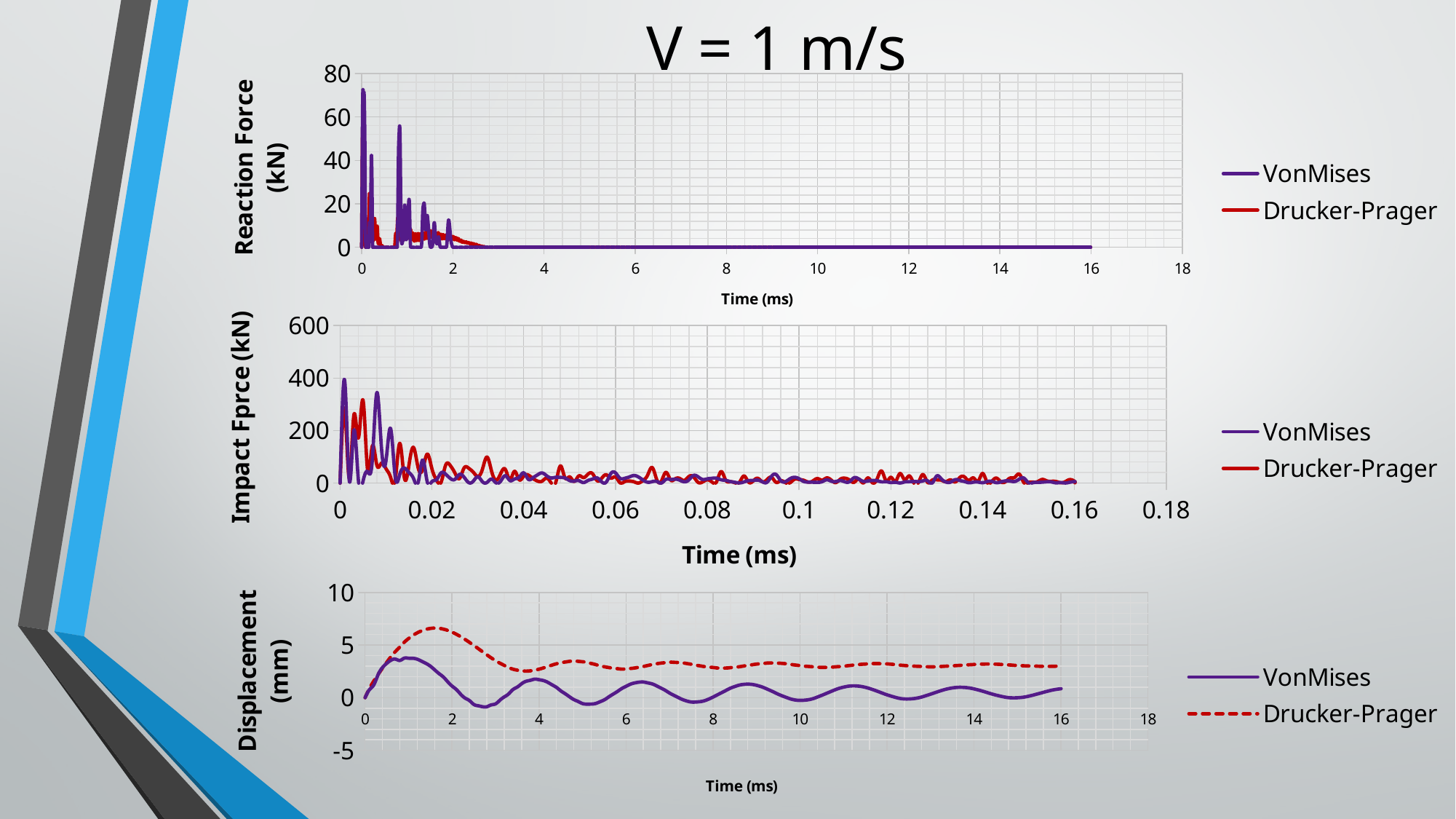
In the bottom chart (Displacement), is the peak value of the VonMises series greater or less than 5? less In the top chart (Reaction Force), which series reaches the higher peak value? VonMises In the bottom chart (Displacement), is the peak value of the Drucker-Prager series greater or less than 5? greater What is the y-axis title of the bottom chart? Displacement (mm) What are the two series named in the legend of the bottom chart (Displacement)? VonMises and Drucker-Prager In the middle chart (Impact Force), which series reaches the higher peak value? VonMises In the top chart (Reaction Force), after the initial spikes, do the values rise or fall as time increases? fall In the bottom chart (Displacement), which series reaches the higher peak displacement? Drucker-Prager In the middle chart (Impact Force), is the peak value of the VonMises series greater or less than 300? greater How many series does the legend of the middle chart (Impact Force) list? 2 What kind of chart is the top chart (Reaction Force)? line chart